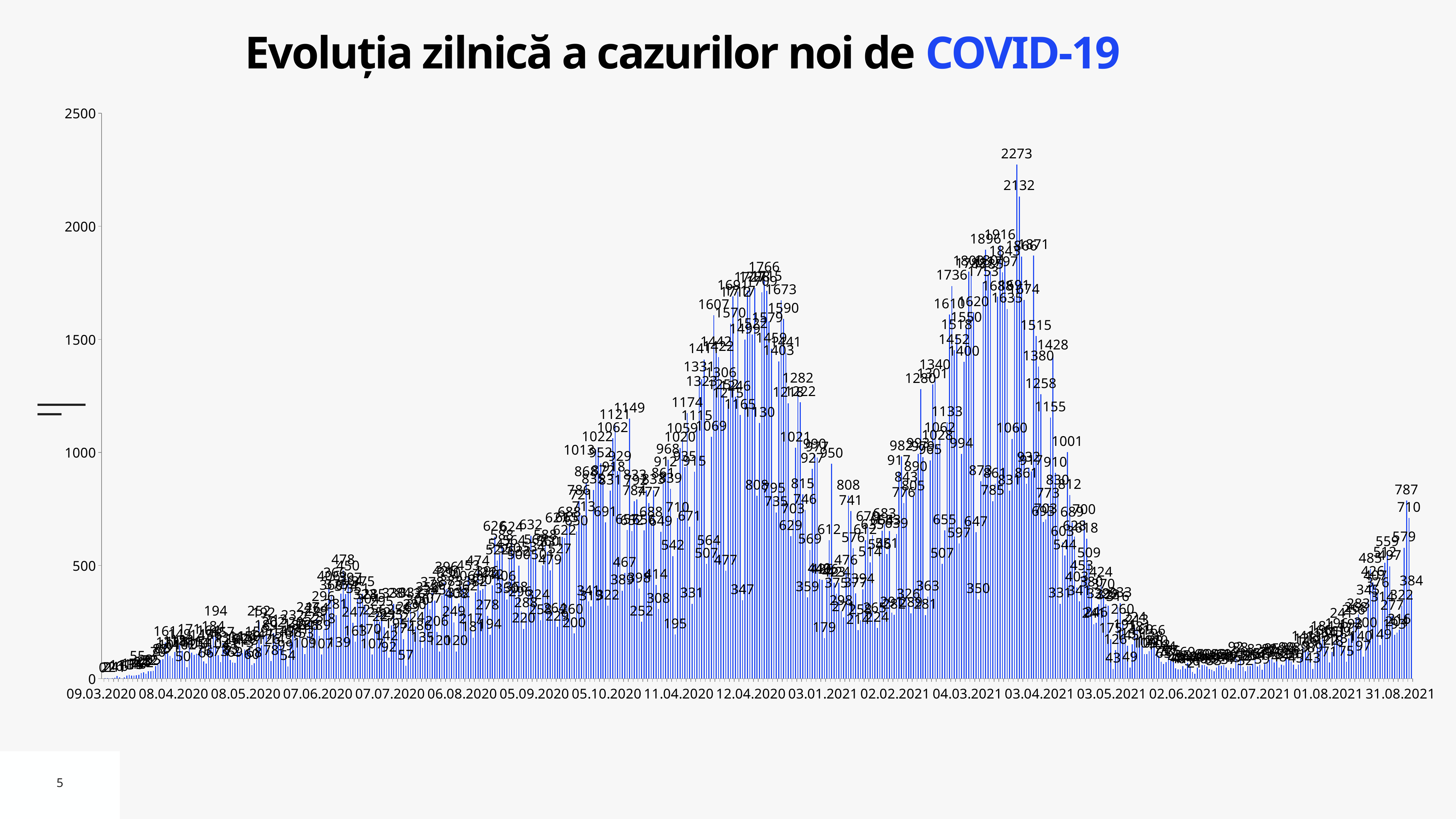
Which is larger: the peak labelled 1766 or the peak labelled 2273? 2273 What are the first and last dates shown on the x axis? 09.03.2020 and 31.08.2021 What is the highest daily value labelled on the chart? 2273 What is the highest value labelled in the rise at the far right end of the chart? 787 Do the values rise or fall between 03.04.2021 and 02.06.2021? fall Is the highest bar on the chart greater or less than 2000? greater Are the bars between 02.06.2021 and 02.07.2021 greater or less than 500? less What kind of chart is shown on the slide? bar chart What is the title of the chart? Evoluția zilnică a cazurilor noi de COVID-19 What is the second-highest value labelled next to the 2273 peak? 2132 What is the difference between the two highest labelled values, 2273 and 2132? 141 Is the peak labelled 1766 greater or less than 1500? greater